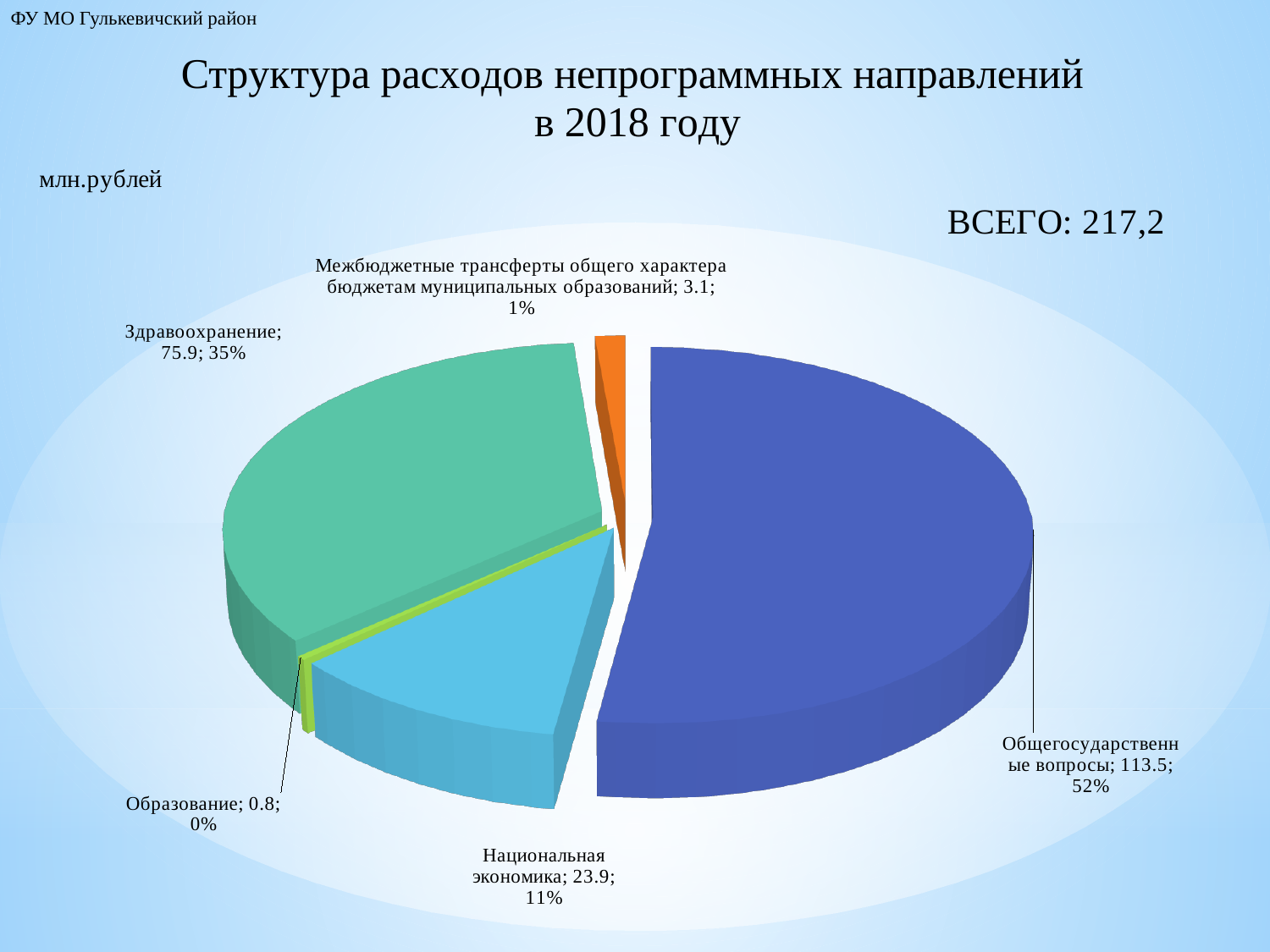
How many slices does the pie chart have? 5 What is the value for Образование? 0.8 What is the difference between the values for Общегосударственные вопросы and Здравоохранение? 37.6 Which category has the largest slice of the pie? Общегосударственные вопросы What is the value for Общегосударственные вопросы? 113.5 Which is larger, the value for Национальная экономика or the value for Межбюджетные трансферты общего характера бюджетам муниципальных образований? Национальная экономика Which category has the smallest slice of the pie? Образование What share of the pie does Межбюджетные трансферты общего характера бюджетам муниципальных образований represent? 1% What kind of chart is shown on the slide? pie chart What is the value for Здравоохранение? 75.9 What is the value for Национальная экономика? 23.9 What share of the pie does Здравоохранение represent? 35%